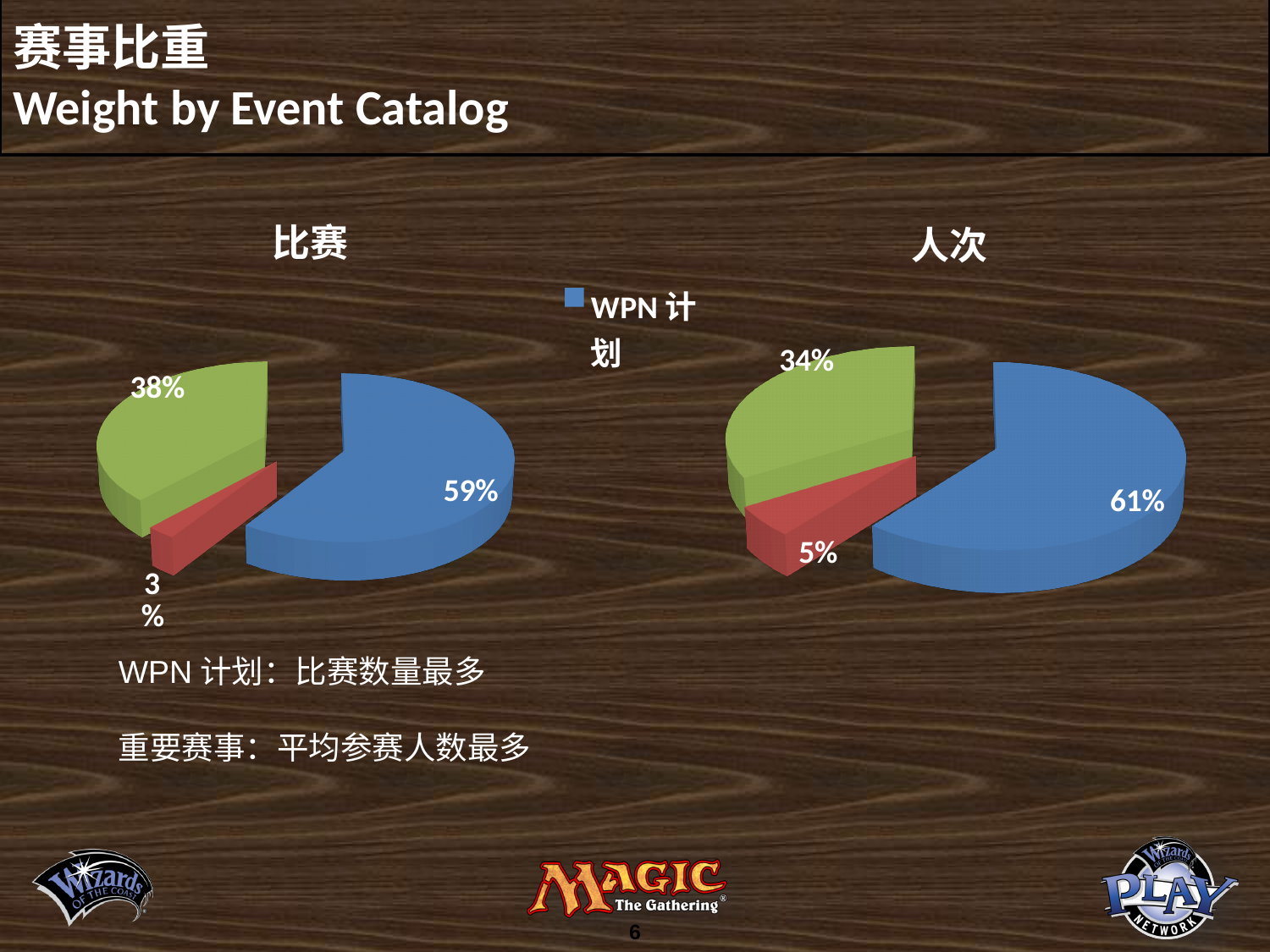
In the 比赛 pie chart, what percentage is shown on the green slice? 38% What type of chart is used on this slide? pie chart In the 比赛 pie chart, what is the difference between the WPN 计划 share and the green slice's share? 21 percentage points In the 人次 pie chart, which slice has the largest share? the blue slice (61%) In the 比赛 pie chart, what share does the WPN 计划 slice have? 59% In the 人次 pie chart, what percentage is shown on the red slice? 5% Which colour represents WPN 计划 in the legend? blue In the 比赛 pie chart, which slice has the smallest share? the red slice (3%) What is the title of the chart on the left? 比赛 How many slices does the 人次 pie chart have? 3